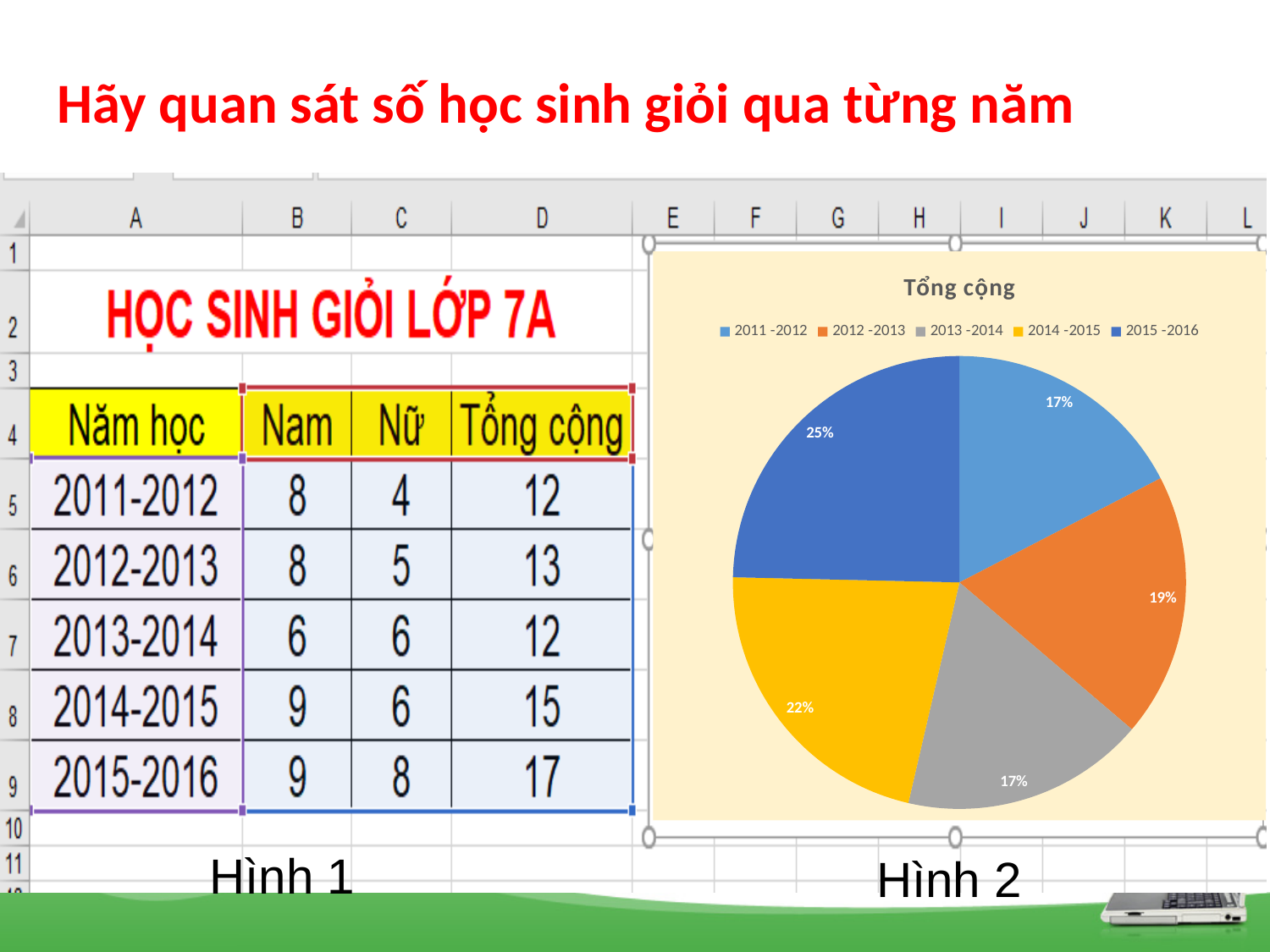
Which is larger in the pie chart, the slice for 2014 -2015 or the slice for 2012 -2013? 2014 -2015 What is the title of the pie chart? Tổng cộng How many slices does the pie chart have? 5 What share of the pie chart does 2015 -2016 have? 25% What is the difference in percentage points between the 2015 -2016 slice and the 2011 -2012 slice? 8 What kind of chart is shown on the slide? pie chart How many entries does the legend of the pie chart list? 5 What share of the pie chart does 2011 -2012 have? 17% What colour is the slice for 2014 -2015 in the pie chart? yellow Which school year has the largest slice in the pie chart? 2015 -2016 What share of the pie chart does 2014 -2015 have? 22%